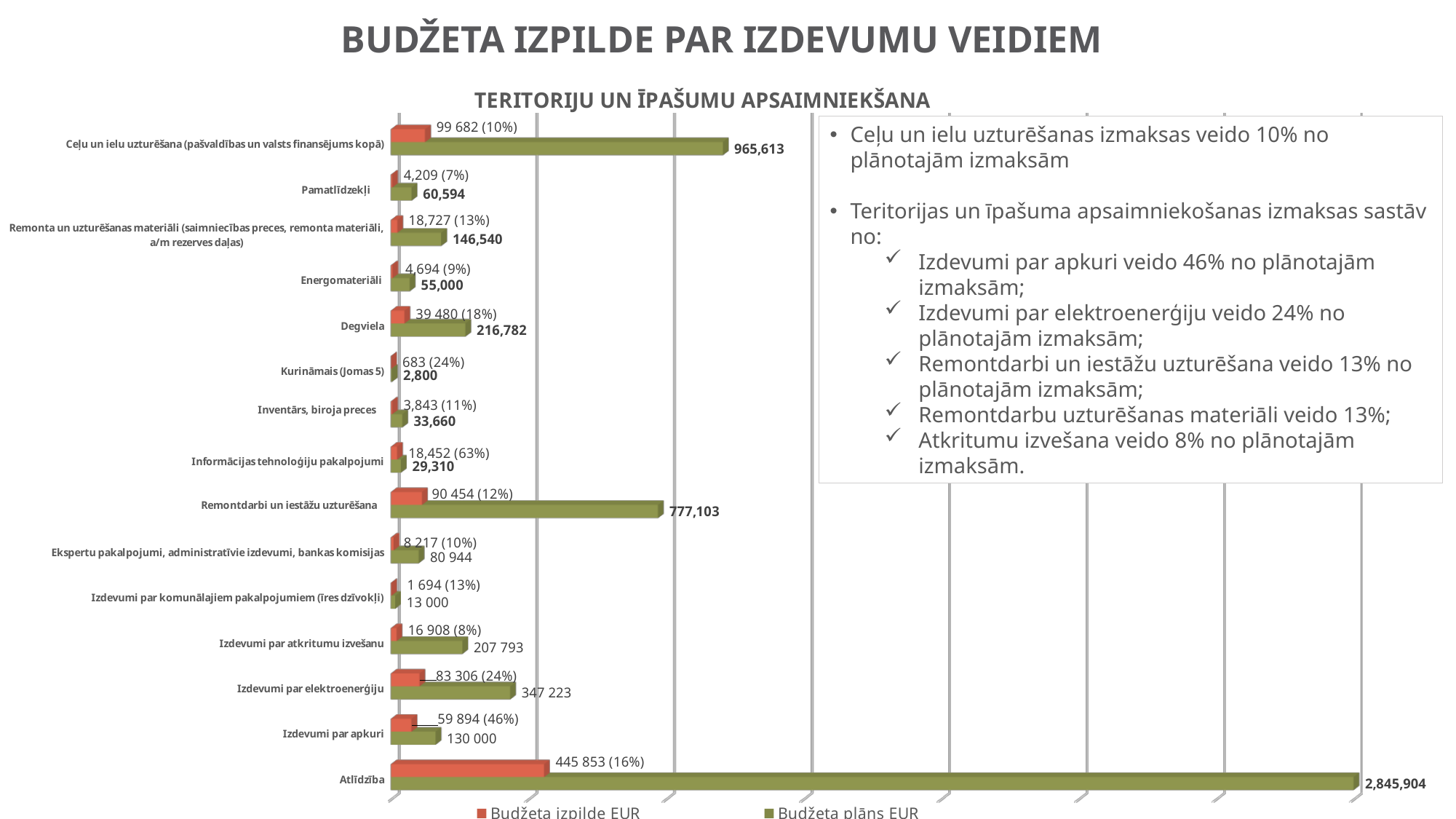
What is the Budžeta plāns EUR value for Remontdarbi un iestāžu uzturēšana? 777,103 Which category has the highest Budžeta plāns EUR value? Atlīdzība Which is larger: the Budžeta plāns EUR value for Izdevumi par elektroenerģiju or for Izdevumi par atkritumu izvešanu? Izdevumi par elektroenerģiju What is the Budžeta izpilde EUR value for Degviela? 39 480 What is the Budžeta plāns EUR value for Atlīdzība? 2,845,904 How many categories are shown on the chart? 15 Which category has the lowest Budžeta plāns EUR value? Kurināmais (Jomas 5) What is the Budžeta izpilde EUR value for Izdevumi par apkuri? 59 894 What kind of chart is shown on the slide? Bar chart What is the difference between the Budžeta plāns EUR and Budžeta izpilde EUR values for Izdevumi par apkuri? 70 106 What is the title of the chart? TERITORIJU UN ĪPAŠUMU APSAIMNIEKŠANA How many series does the legend list? 2